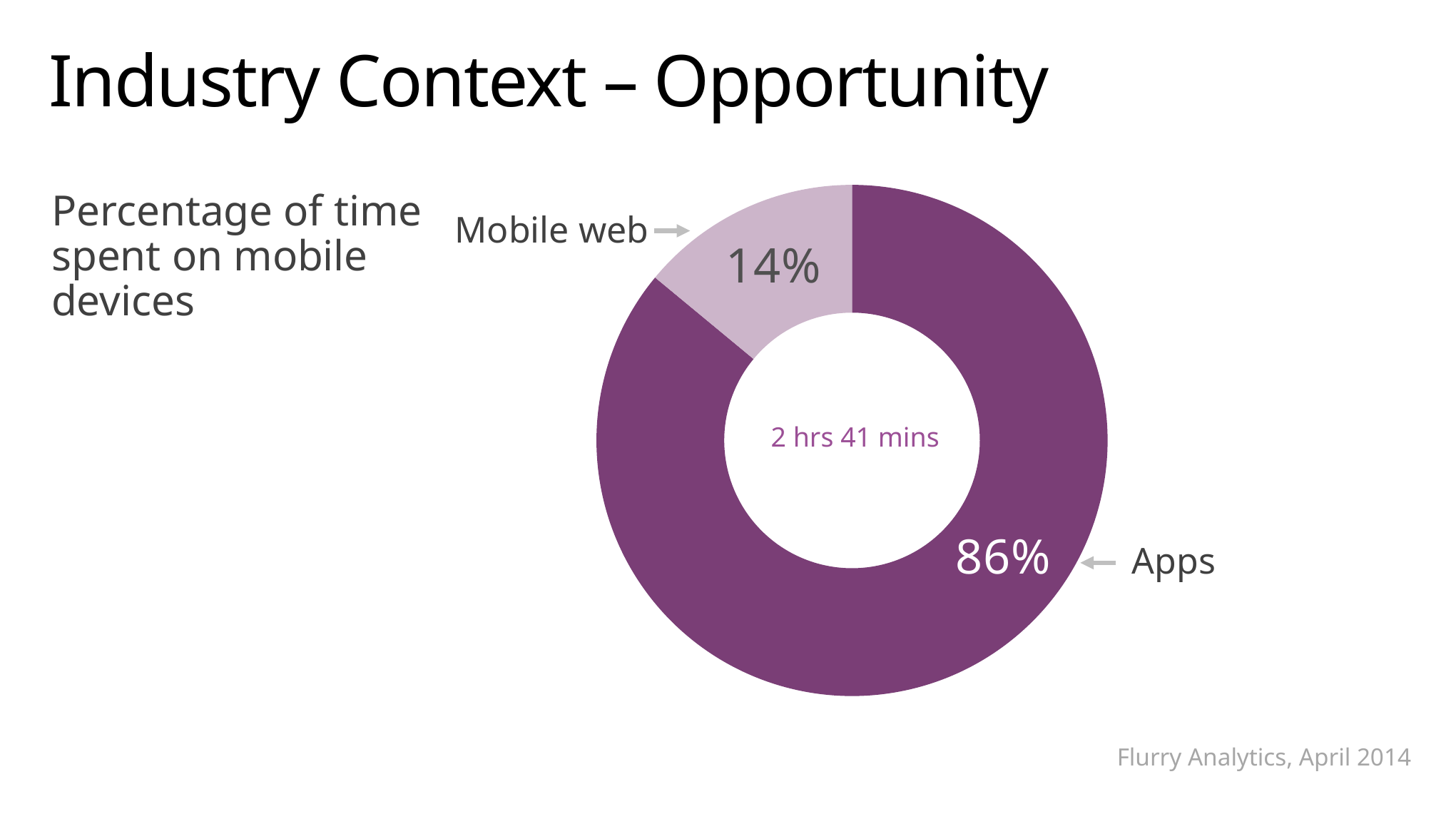
What percentage of time spent on mobile devices is spent on Apps? 86% What is the difference in percentage points between the Apps share and the Mobile web share? 72 How many categories does the chart show? 2 What is the source cited for the chart data? Flurry Analytics, April 2014 Which category accounts for the largest share of time spent on mobile devices? Apps Which category accounts for the smallest share of time spent on mobile devices? Mobile web What kind of chart is shown on the slide? Doughnut chart Which is larger, the share for Apps or the share for Mobile web? Apps What percentage of time spent on mobile devices is spent on Mobile web? 14% What text is shown in the centre of the doughnut chart? 2 hrs 41 mins